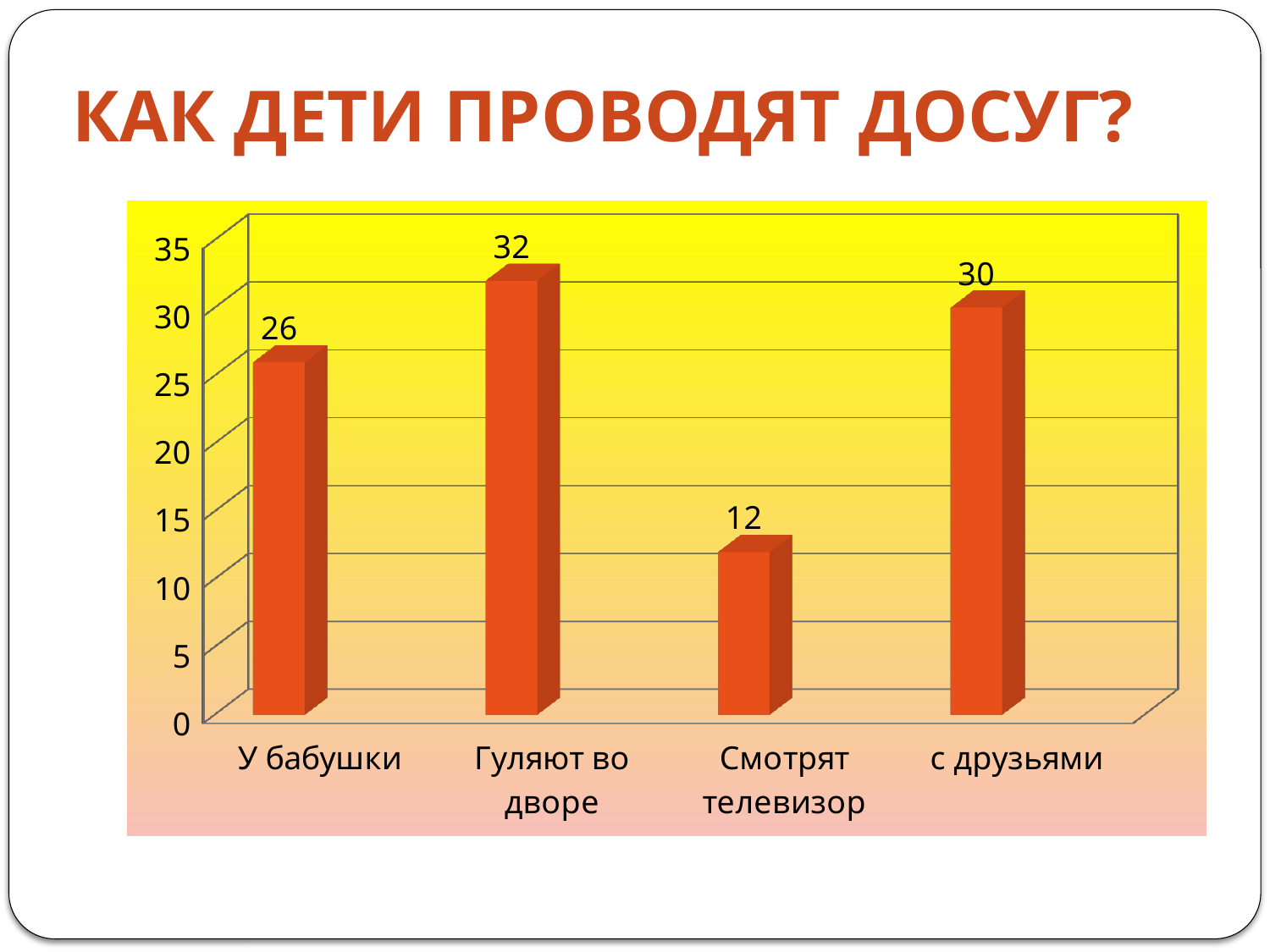
What is the value for У бабушки? 26 What is the value for Гуляют во дворе? 32 What is the value for с друзьями? 30 What is the difference between the values for Гуляют во дворе and Смотрят телевизор? 20 Which category has the highest value? Гуляют во дворе What is the title of the slide? КАК ДЕТИ ПРОВОДЯТ ДОСУГ? What is the value for Смотрят телевизор? 12 What is the difference between the values for с друзьями and У бабушки? 4 What kind of chart is shown on the slide? bar chart How many categories are shown on the chart? 4 Which is larger, the value for У бабушки or the value for с друзьями? с друзьями Which category has the lowest value? Смотрят телевизор